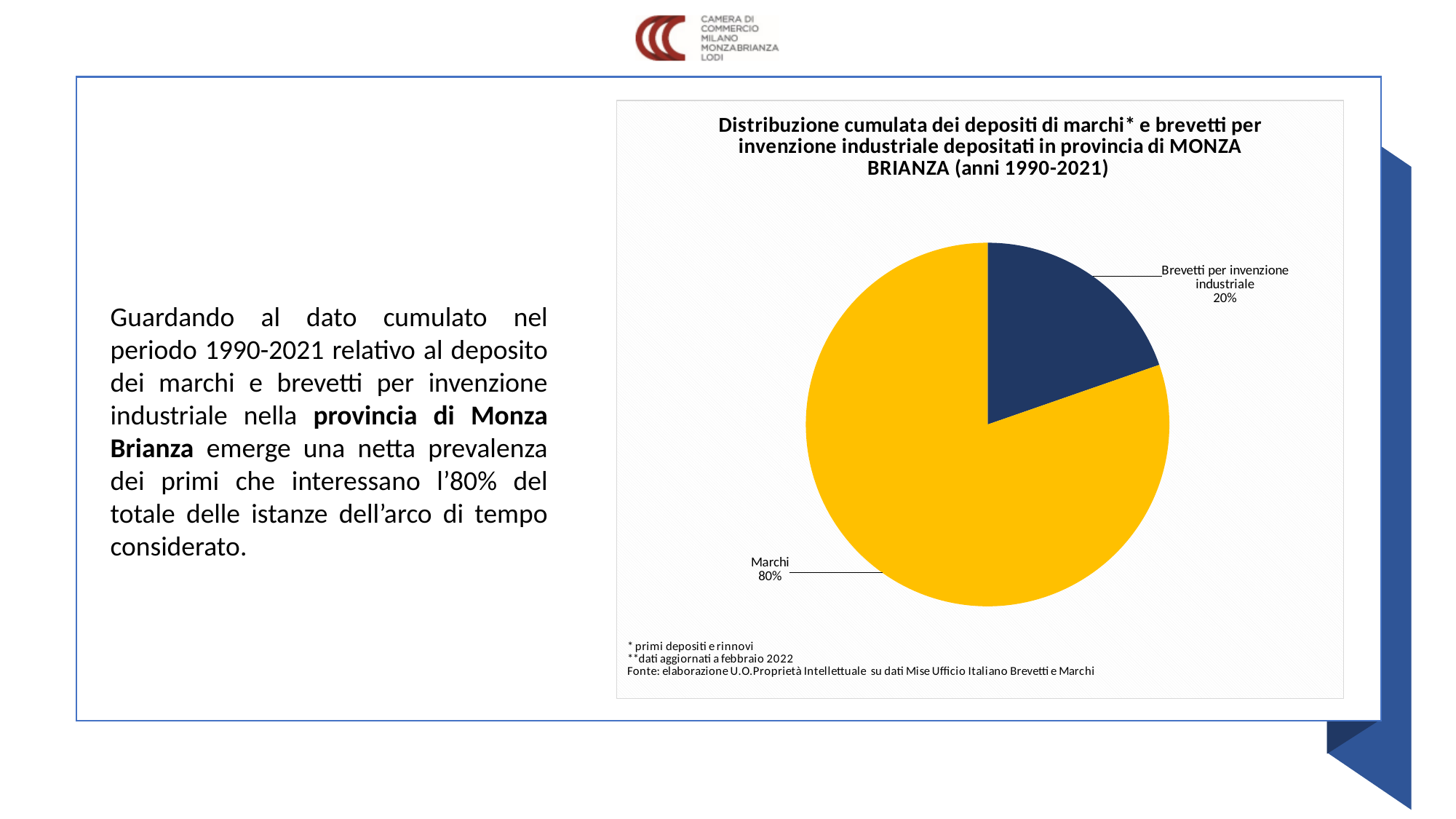
What colour is the Marchi slice? Yellow What share of the pie does Marchi represent? 80% What is the difference in percentage points between the Marchi share and the Brevetti per invenzione industriale share? 60 percentage points What range of years does the chart title say the data covers? 1990-2021 How many slices does the pie chart have? 2 Which is larger, the share for Marchi or the share for Brevetti per invenzione industriale? Marchi What share of the pie does Brevetti per invenzione industriale represent? 20% What kind of chart is shown on the slide? Pie chart Which category has the smallest slice of the pie? Brevetti per invenzione industriale Which category has the largest slice of the pie? Marchi